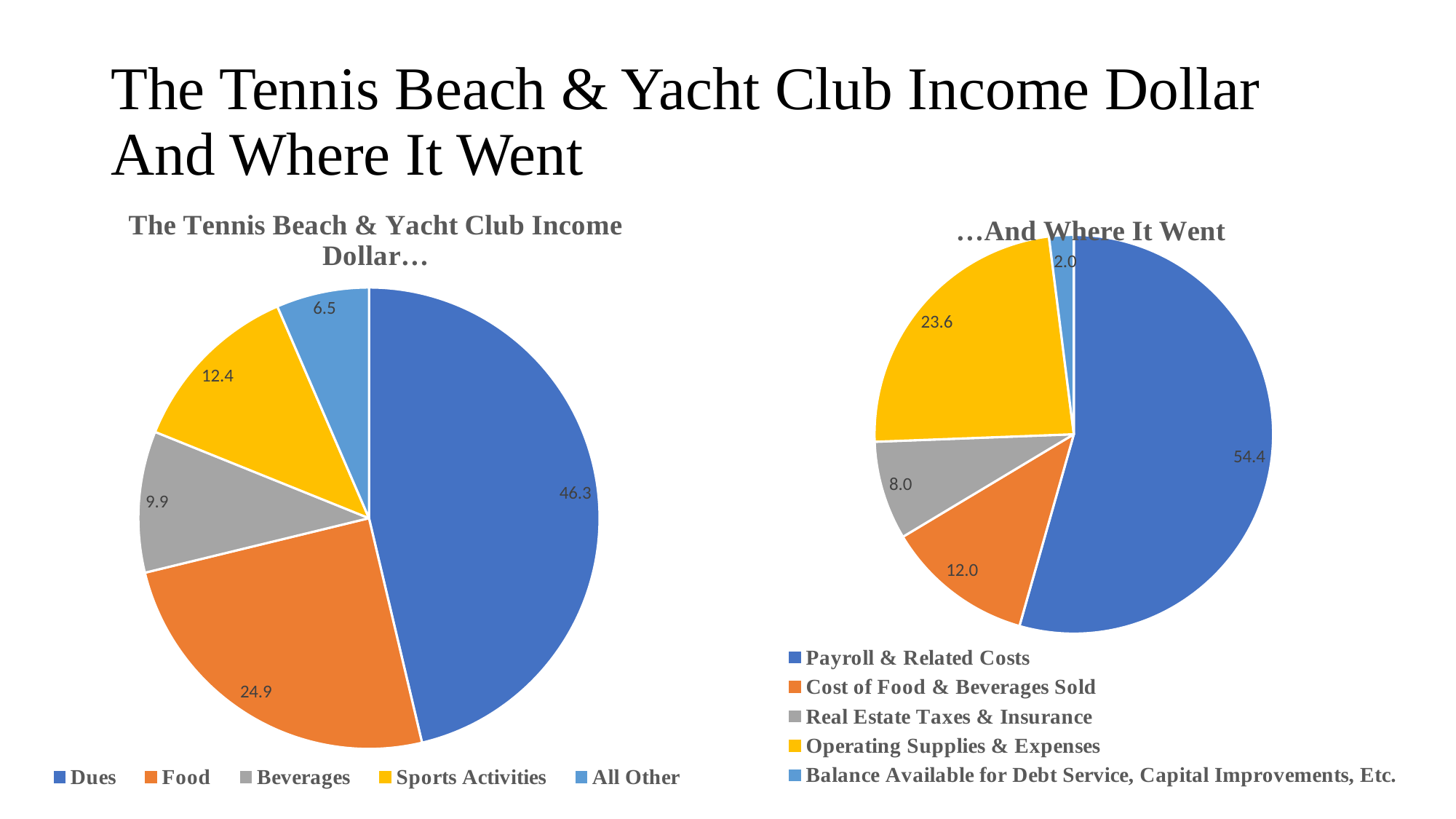
In the right pie chart (…And Where It Went), what is the value for Balance Available for Debt Service, Capital Improvements, Etc.? 2.0 In the right pie chart (…And Where It Went), what is the value for Operating Supplies & Expenses? 23.6 In the left pie chart (The Tennis Beach & Yacht Club Income Dollar…), what is the value for Food? 24.9 In the left pie chart (The Tennis Beach & Yacht Club Income Dollar…), what is the value for Dues? 46.3 What kind of chart is the left chart (The Tennis Beach & Yacht Club Income Dollar…)? Pie chart In the right pie chart (…And Where It Went), what is the difference between Payroll & Related Costs and Operating Supplies & Expenses? 30.8 In the left pie chart (The Tennis Beach & Yacht Club Income Dollar…), what colour is the Sports Activities slice? Yellow In the left pie chart (The Tennis Beach & Yacht Club Income Dollar…), which is larger, Beverages or Sports Activities? Sports Activities In the left pie chart (The Tennis Beach & Yacht Club Income Dollar…), which category has the largest slice? Dues In the right pie chart (…And Where It Went), which category has the largest slice? Payroll & Related Costs In the left pie chart (The Tennis Beach & Yacht Club Income Dollar…), which category has the smallest slice? All Other How many categories does the legend of the right pie chart (…And Where It Went) list? 5